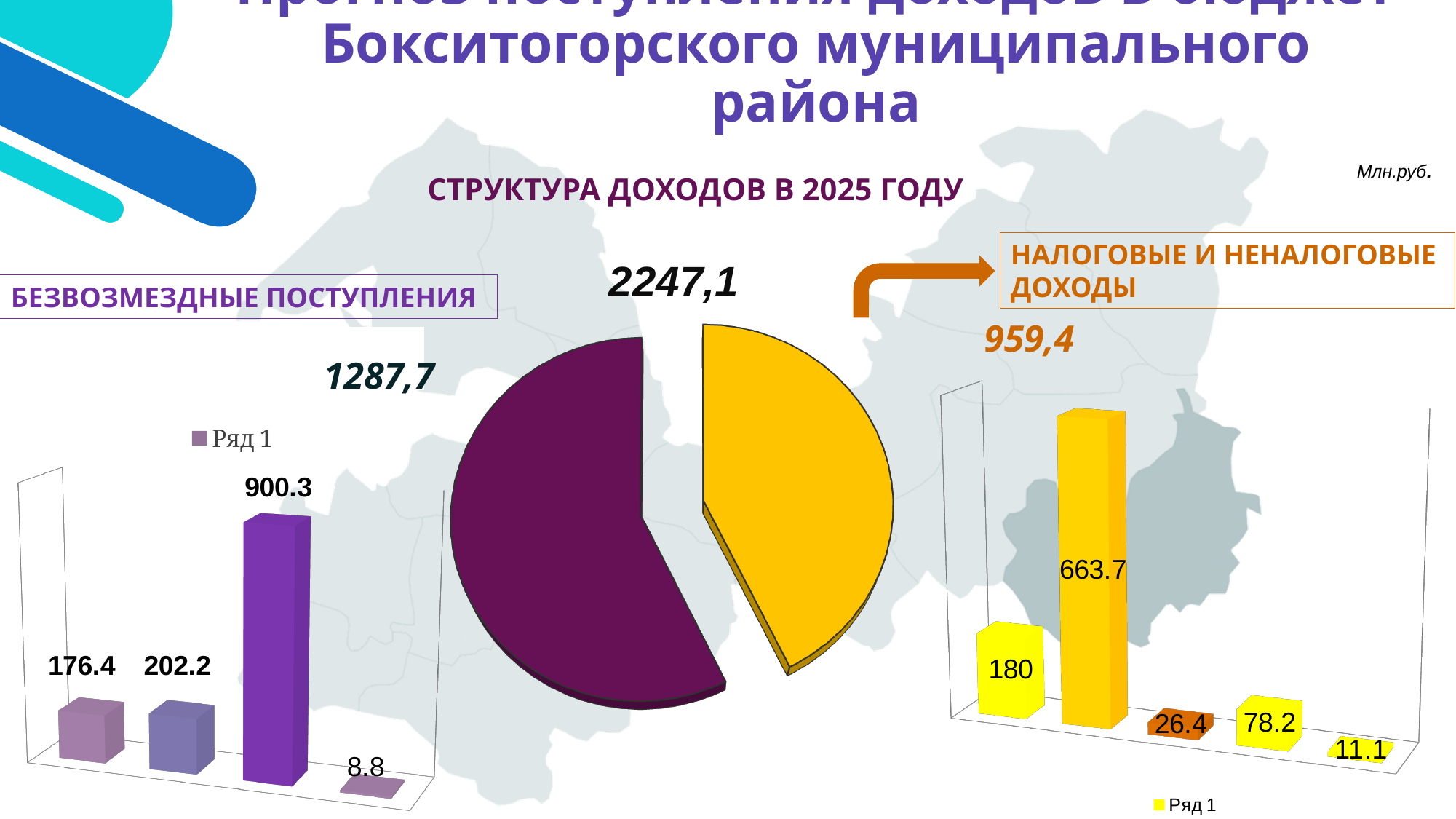
In the central pie chart, what is the value of the purple slice labelled 'БЕЗВОЗМЕЗДНЫЕ ПОСТУПЛЕНИЯ'? 1287,7 In the central pie chart, what is the value of the yellow slice labelled 'НАЛОГОВЫЕ И НЕНАЛОГОВЫЕ ДОХОДЫ'? 959,4 What type of chart is the chart on the left side of the slide, under 'БЕЗВОЗМЕЗДНЫЕ ПОСТУПЛЕНИЯ'? bar chart What is the lowest value shown in the right bar chart under 'НАЛОГОВЫЕ И НЕНАЛОГОВЫЕ ДОХОДЫ'? 11.1 How many bars are in the left bar chart under 'БЕЗВОЗМЕЗДНЫЕ ПОСТУПЛЕНИЯ'? 4 What type of chart is the central chart titled 'СТРУКТУРА ДОХОДОВ В 2025 ГОДУ'? pie chart How many bars are in the right bar chart under 'НАЛОГОВЫЕ И НЕНАЛОГОВЫЕ ДОХОДЫ'? 5 In the central pie chart, which slice is larger: 'БЕЗВОЗМЕЗДНЫЕ ПОСТУПЛЕНИЯ' or 'НАЛОГОВЫЕ И НЕНАЛОГОВЫЕ ДОХОДЫ'? БЕЗВОЗМЕЗДНЫЕ ПОСТУПЛЕНИЯ In the central pie chart, what is the difference between the 'БЕЗВОЗМЕЗДНЫЕ ПОСТУПЛЕНИЯ' slice and the 'НАЛОГОВЫЕ И НЕНАЛОГОВЫЕ ДОХОДЫ' slice? 328,3 How many slices does the central pie chart have? 2 What is the highest value shown in the left bar chart under 'БЕЗВОЗМЕЗДНЫЕ ПОСТУПЛЕНИЯ'? 900.3 What total value is printed above the central pie chart? 2247,1